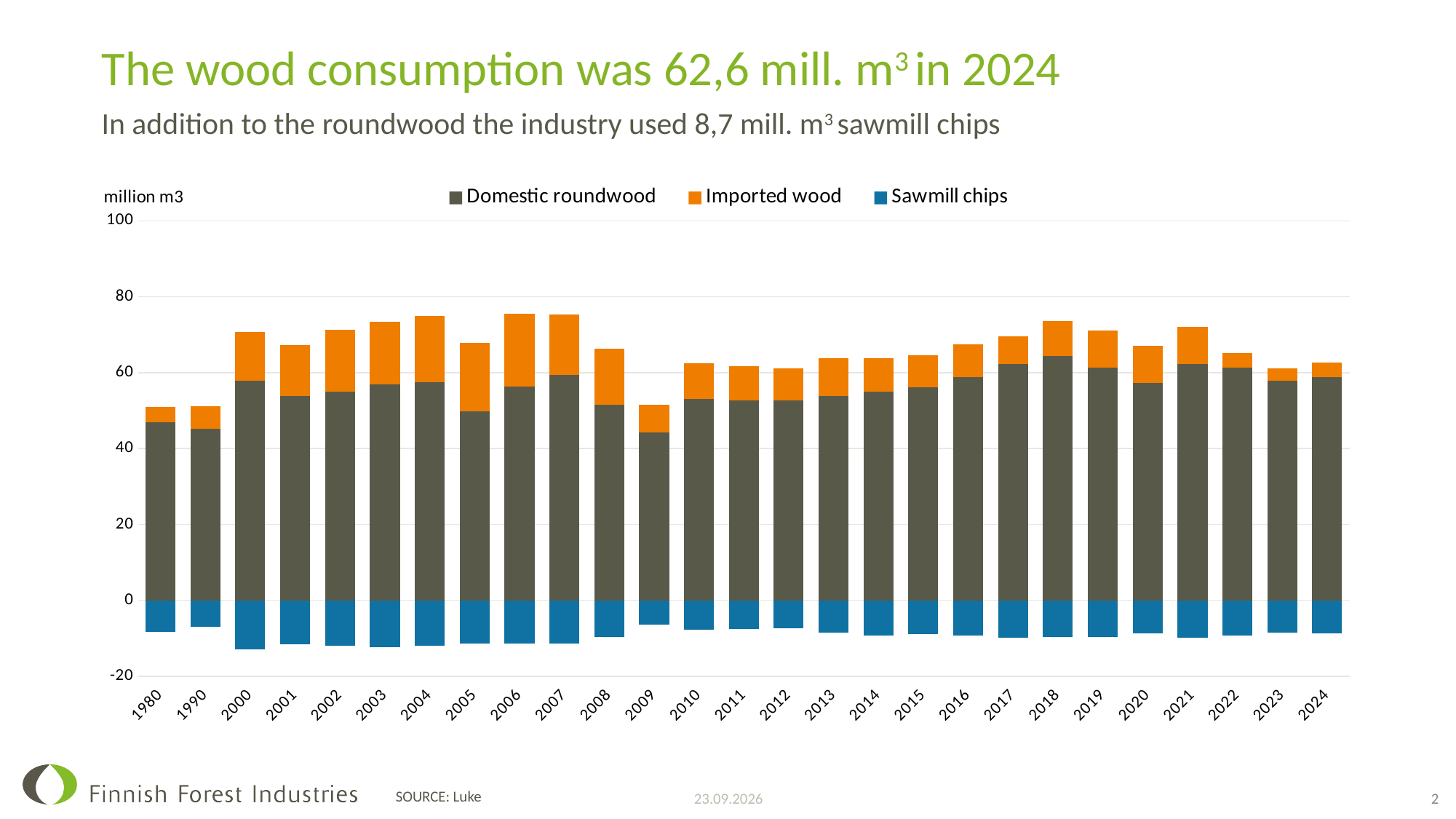
Is the Domestic roundwood value for 2018 greater or less than 60? greater Which year has the highest Domestic roundwood value? 2018 Is the Domestic roundwood value for 1980 greater or less than 60? less Which year has the larger Domestic roundwood value, 2000 or 2009? 2000 According to the slide subtitle, how much sawmill chips did the industry use in addition to roundwood? 8,7 mill. m3 What kind of chart is shown on the slide? bar chart According to the slide title, what was the wood consumption in 2024? 62,6 mill. m3 How many series does the chart legend list? 3 Which colour represents Sawmill chips in the chart? blue Which year has the larger Imported wood value, 2006 or 2024? 2006 Is the Domestic roundwood value for 2009 greater or less than 60? less How many years are shown on the x axis of the chart? 27